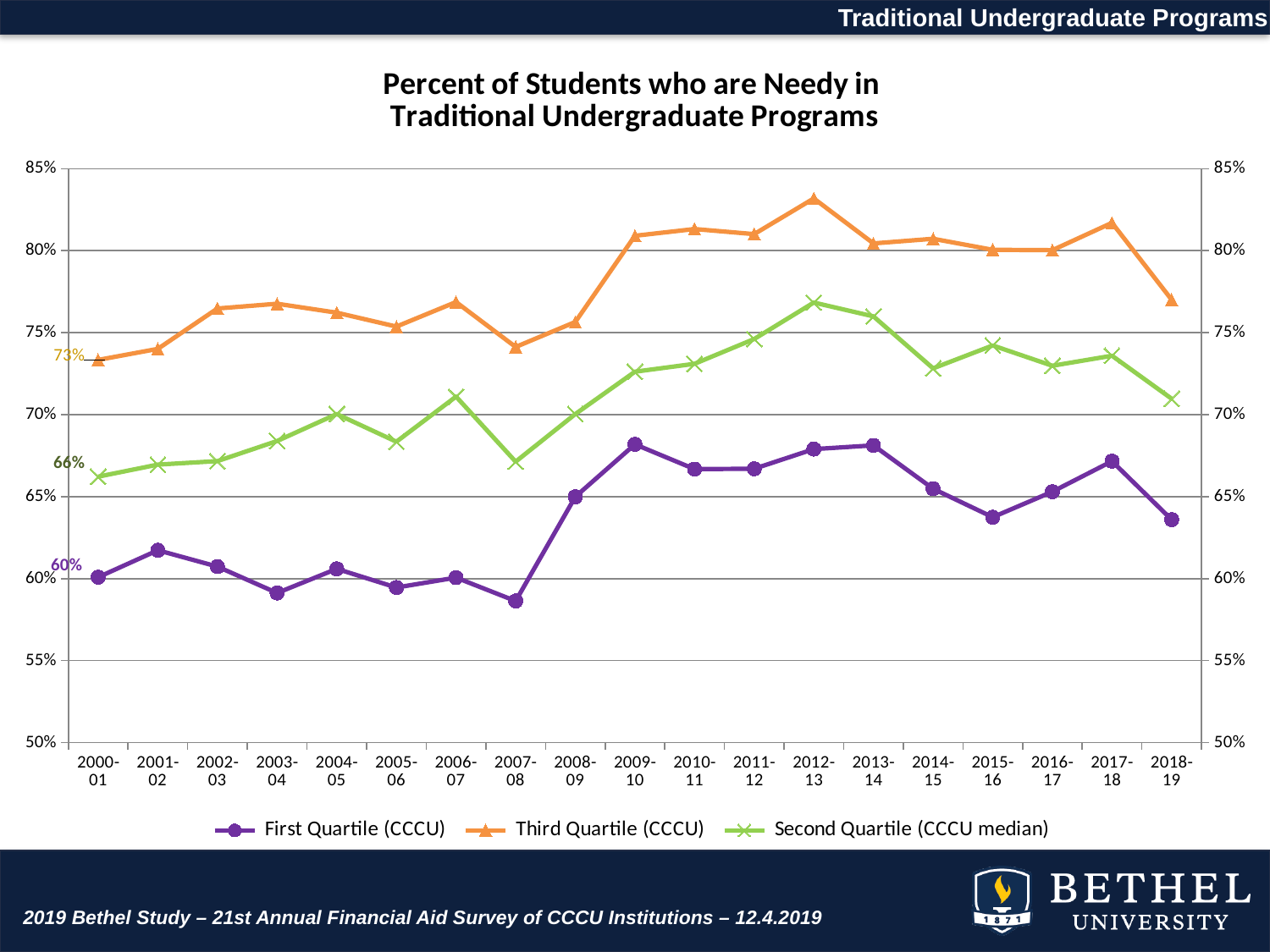
Is the First Quartile (CCCU) value for 2007-08 greater or less than 60%? less Is the Third Quartile (CCCU) value for 2012-13 greater or less than 80%? greater Does the First Quartile (CCCU) series rise or fall from 2017-18 to 2018-19? Fall How many series does the legend list? 3 What kind of chart is shown on the slide? Line chart What is the Third Quartile (CCCU) value for 2000-01? 73% What is the First Quartile (CCCU) value for 2000-01? 60% In which academic year does the Third Quartile (CCCU) series reach its highest value? 2012-13 How many academic years are shown on the x axis? 19 In 2000-01, how much higher is the Third Quartile (CCCU) value than the First Quartile (CCCU) value? 13 percentage points What is the Second Quartile (CCCU median) value for 2000-01? 66% Which is larger for the Third Quartile (CCCU) series: the value for 2008-09 or the value for 2009-10? 2009-10